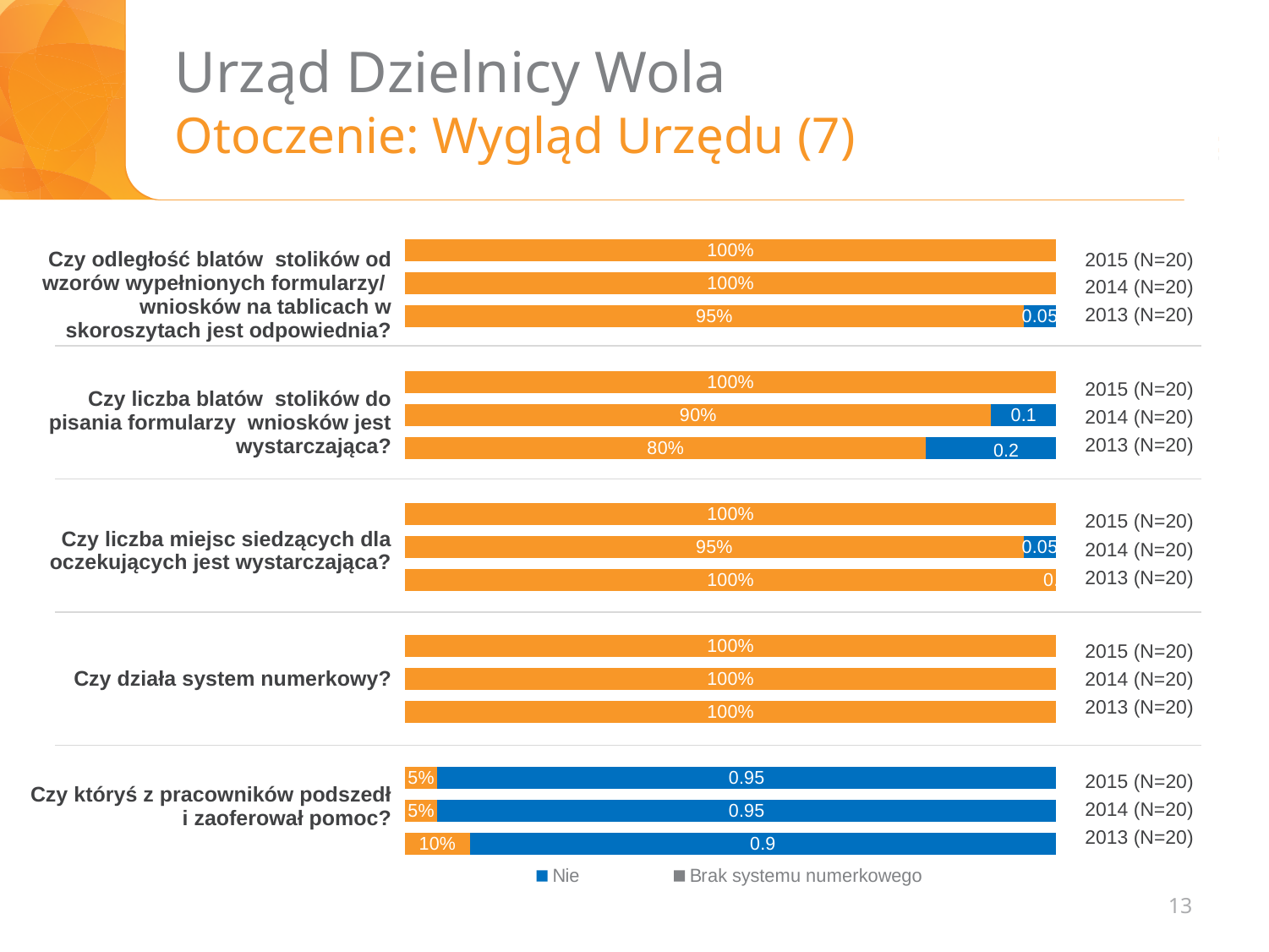
In the chart for "Czy któryś z pracowników podszedł i zaoferował pomoc?", what is the blue value for 2013 (N=20)? 0.9 In the chart for "Czy liczba blatów stolików do pisania formularzy wniosków jest wystarczająca?", is the orange value for 2014 (N=20) larger or smaller than for 2013 (N=20)? larger What type of chart is used on this slide? Stacked bar chart In the chart for "Czy liczba blatów stolików do pisania formularzy wniosków jest wystarczająca?", which year has the lowest orange value? 2013 (N=20) In the chart for "Czy odległość blatów stolików od wzorów wypełnionych formularzy/wniosków na tablicach w skoroszytach jest odpowiednia?", what is the orange value for 2013 (N=20)? 95% In the chart for "Czy liczba blatów stolików do pisania formularzy wniosków jest wystarczająca?", what is the orange value for 2013 (N=20)? 80% In the chart for "Czy liczba miejsc siedzących dla oczekujących jest wystarczająca?", what is the blue value for 2014 (N=20)? 0.05 In the chart for "Czy któryś z pracowników podszedł i zaoferował pomoc?", what is the orange value for 2015 (N=20)? 5% In the chart for "Czy któryś z pracowników podszedł i zaoferował pomoc?", which year has the highest orange value? 2013 (N=20) In the chart for "Czy działa system numerkowy?", how many year bars are shown? 3 In the chart for "Czy liczba blatów stolików do pisania formularzy wniosków jest wystarczająca?", what is the blue value for 2014 (N=20)? 0.1 In the chart for "Czy liczba blatów stolików do pisania formularzy wniosków jest wystarczająca?", what is the difference between the orange values for 2015 (N=20) and 2013 (N=20)? 20%